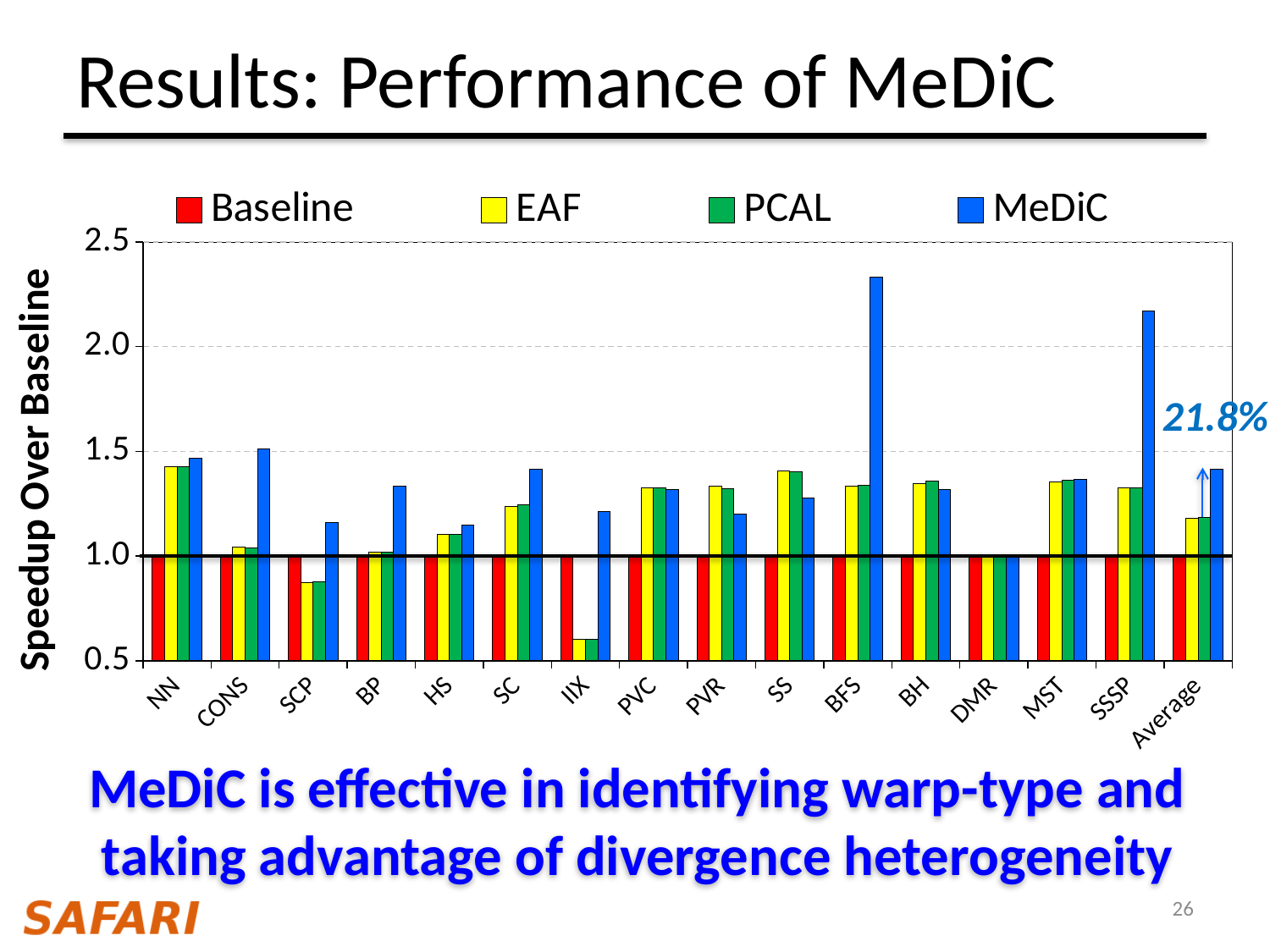
How many categories are shown along the x axis? 16 Is the MeDiC value for SCP greater or less than 1.5? less What is the Baseline value for NN? 1.0 Is the PCAL value for IIX greater or less than 1.0? less Which category has the lowest EAF bar? IIX How many series does the legend list? 4 For PVR, which is larger: the EAF value or the MeDiC value? EAF For BFS, which is larger: the EAF value or the MeDiC value? MeDiC Is the MeDiC value for BFS greater or less than 2.0? greater Which category has the highest MeDiC bar? BFS What percentage is annotated next to the Average bars? 21.8% What kind of chart is shown on the slide? bar chart